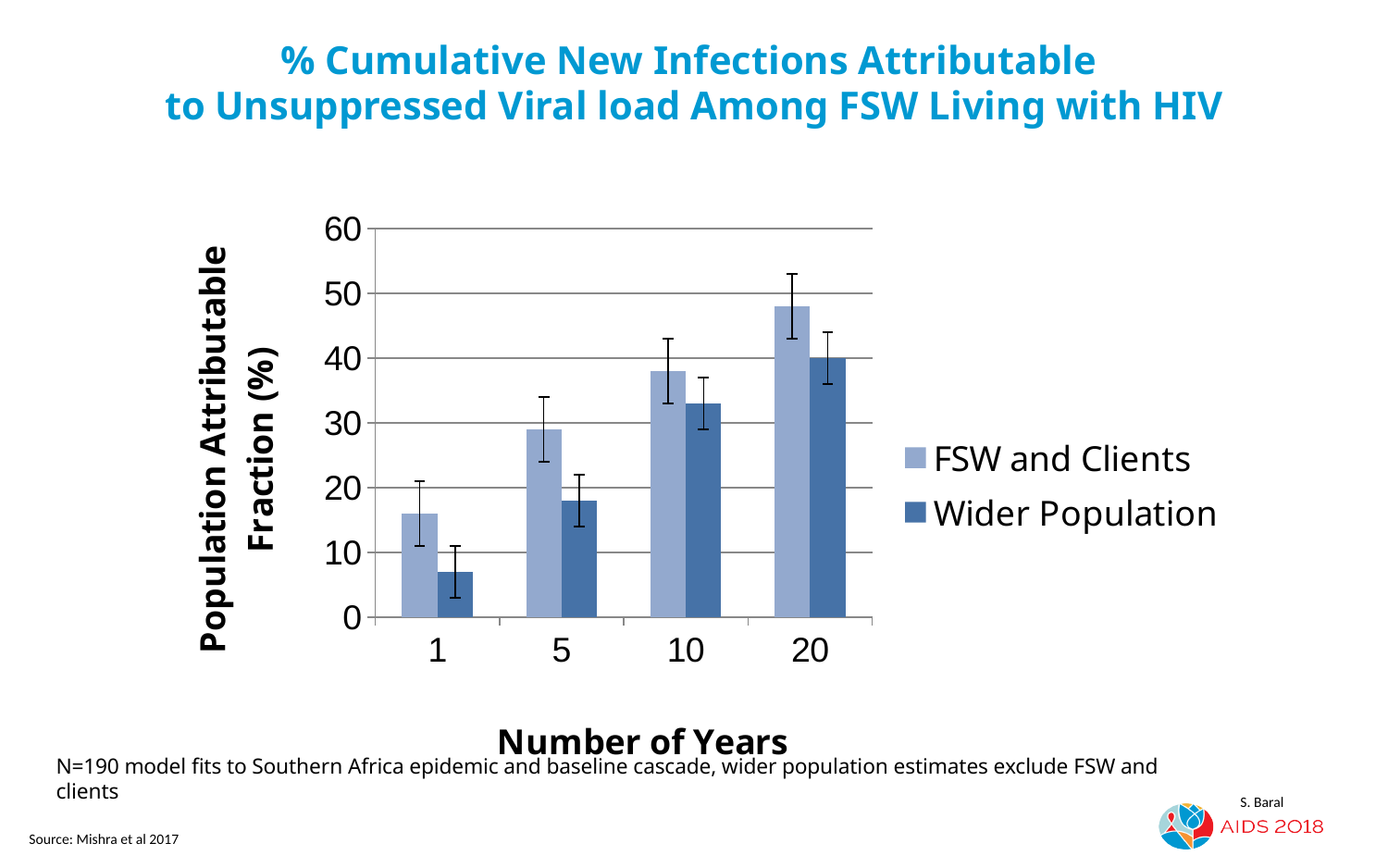
At 1 year, which series has the larger value, FSW and Clients or Wider Population? FSW and Clients Is the value for Wider Population at 1 year greater or less than 10? less Which number of years has the highest value for FSW and Clients? 20 Is the value for FSW and Clients at 5 years greater or less than 20? greater Do the values for Wider Population rise or fall as the number of years increases? rise Is the value for Wider Population at 10 years greater or less than 40? less How many series does the legend list? 2 What kind of chart is shown on the slide? bar chart What is the label of the y axis? Population Attributable Fraction (%) Which number of years has the lowest value for Wider Population? 1 How many categories are shown on the x axis? 4